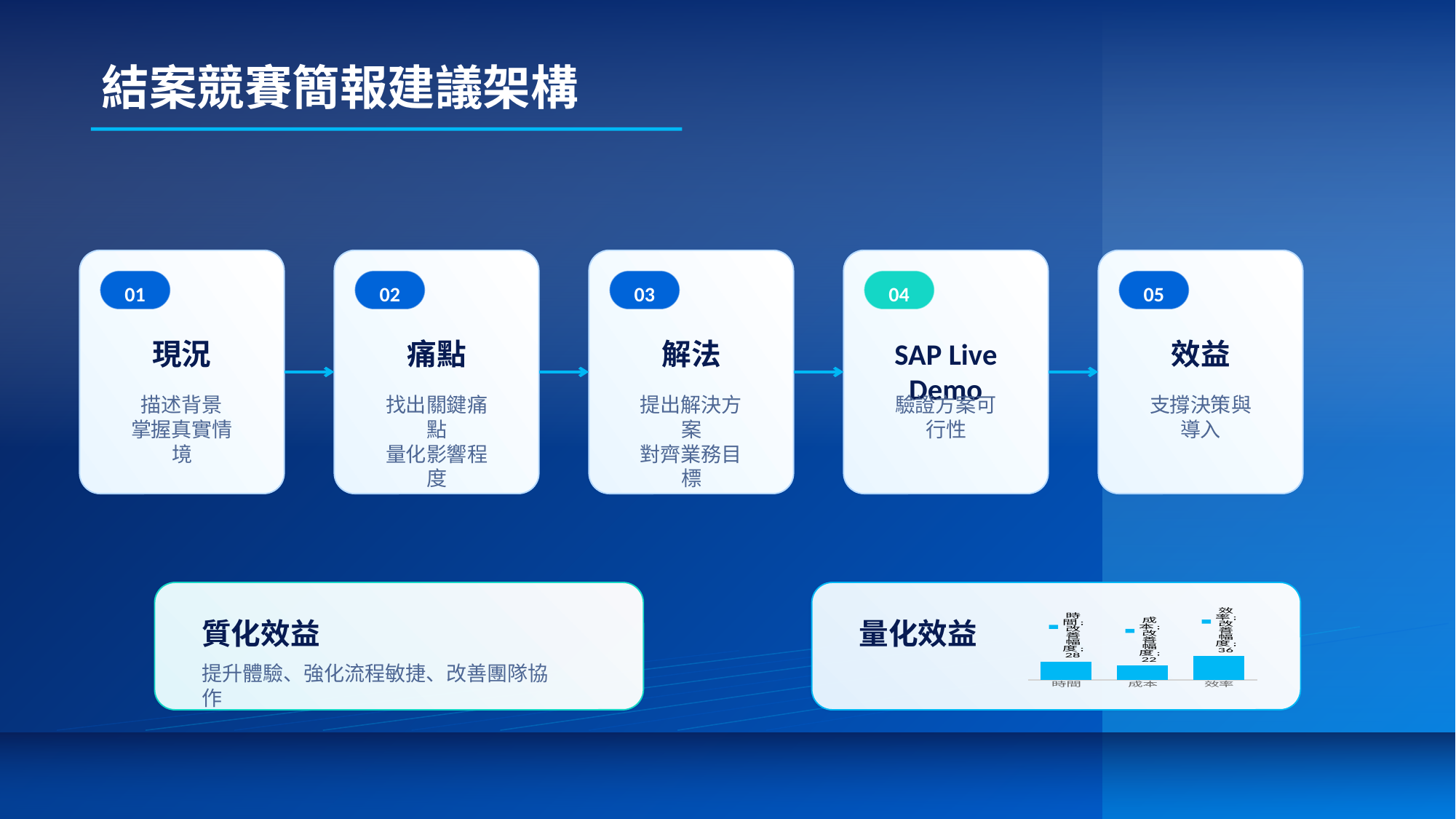
In the 量化效益 bar chart, what is the value for 效率? 36 In the 量化效益 bar chart, what is the value for 時間? 28 In the 量化效益 bar chart, what is the difference between the values for 效率 and 成本? 14 In the 量化效益 bar chart, which category has the lowest value? 成本 How many categories does the bar chart in the 量化效益 box show? 3 What kind of chart is shown in the 量化效益 box? bar chart In the 量化效益 bar chart, which category has the highest value? 效率 In the 量化效益 bar chart, which is larger, the value for 時間 or the value for 效率? 效率 In the 量化效益 bar chart, what is the difference between the values for 時間 and 成本? 6 In the 量化效益 bar chart, what is the total of the three values? 86 In the 量化效益 bar chart, what is the value for 成本? 22 What colour are the bars in the 量化效益 bar chart? light blue